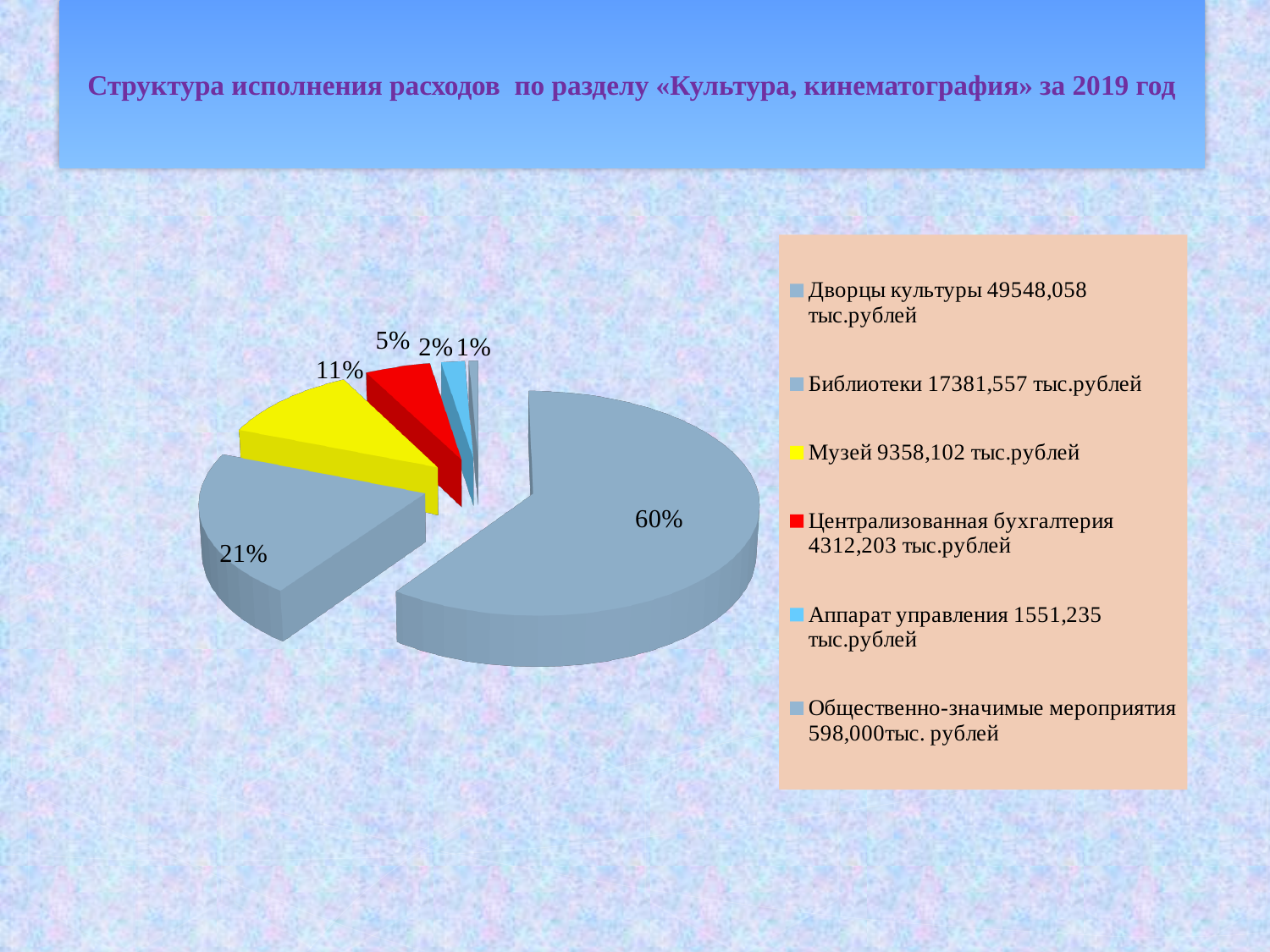
What amount in тыс.рублей does the legend give for Музей? 9358,102 тыс.рублей What share of the pie does Дворцы культуры take? 60% How many slices does the pie chart have? 6 Which category has the largest slice of the pie? Дворцы культуры What share of the pie does Музей take? 11% What share of the pie does Библиотеки take? 21% What colour is the Централизованная бухгалтерия slice? Red Which category has the smallest slice of the pie? Общественно-значимые мероприятия What is the difference in percentage points between the Дворцы культуры slice and the Библиотеки slice? 39 percentage points Which slice is larger, Музей or Аппарат управления? Музей What kind of chart is shown on the slide? Pie chart